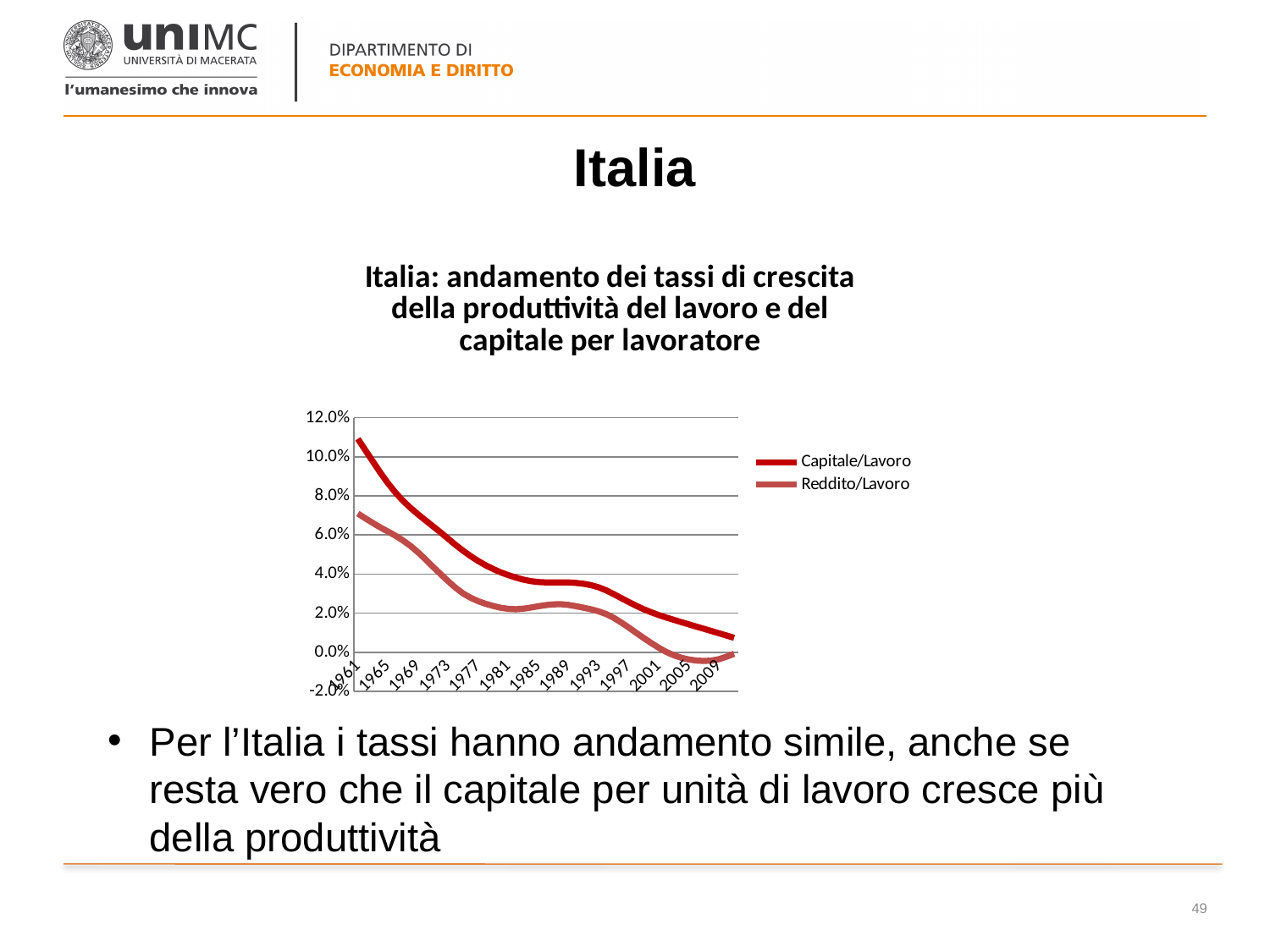
Is the value for Reddito/Lavoro in 2005 greater or less than 0.0%? less Do the values of the Capitale/Lavoro series rise or fall from 1961 to 2009? fall How many year labels are shown on the x axis? 13 Is the value for Reddito/Lavoro in 1961 greater or less than 8.0%? less What are the two series named in the legend? Capitale/Lavoro and Reddito/Lavoro Do the values of the Reddito/Lavoro series rise or fall from 1961 to 1981? fall In 1961, which series has the higher value, Capitale/Lavoro or Reddito/Lavoro? Capitale/Lavoro Is the value for Capitale/Lavoro in 1961 greater or less than 10.0%? greater What is the title of the chart? Italia: andamento dei tassi di crescita della produttività del lavoro e del capitale per lavoratore How many series does the legend list? 2 What kind of chart is shown on the slide? line chart